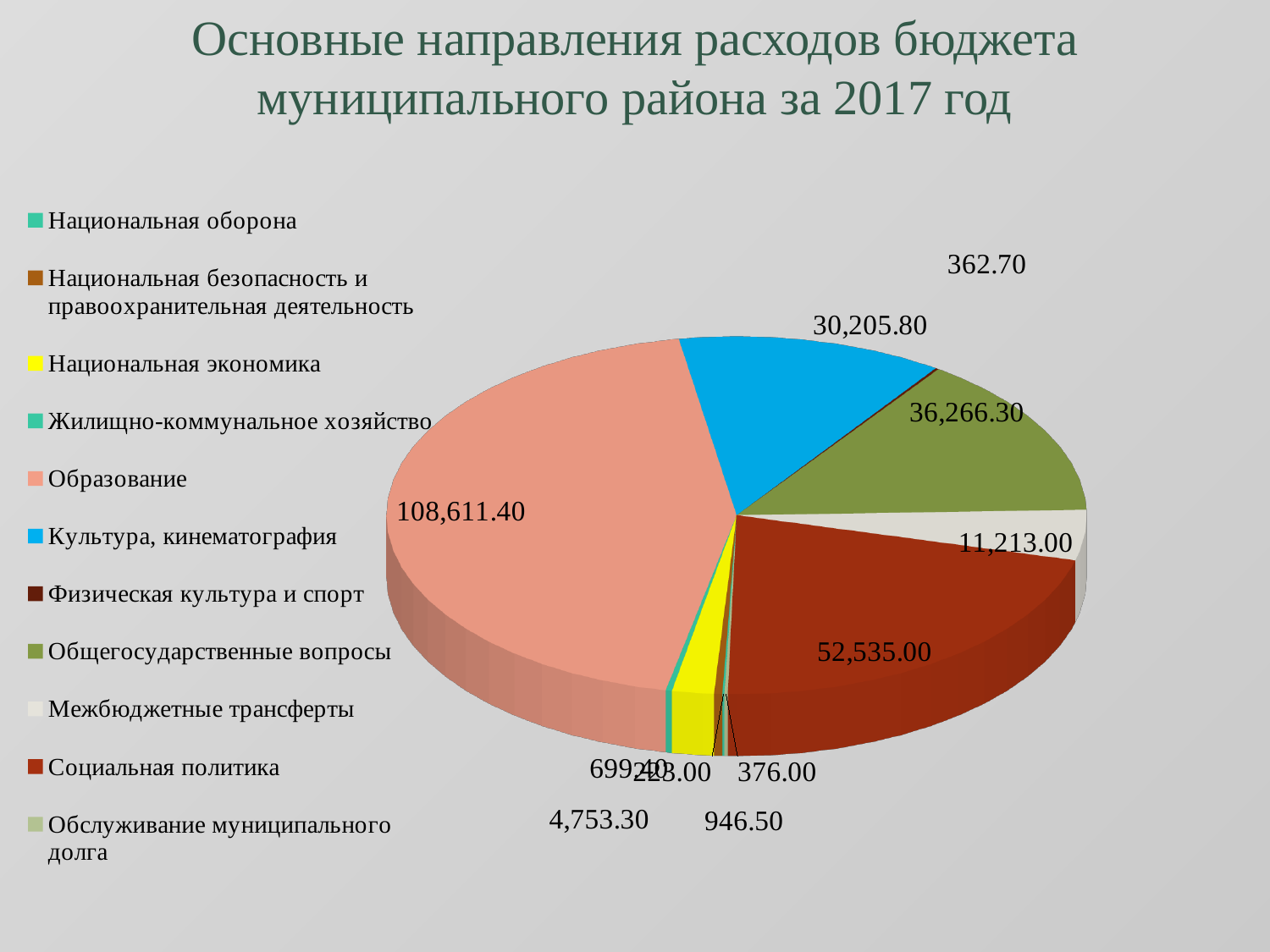
What is the value for Социальная политика? 52,535.00 What is the title of the chart? Основные направления расходов бюджета муниципального района за 2017 год What is the value for Межбюджетные трансферты? 11,213.00 Which is larger, Социальная политика or Общегосударственные вопросы? Социальная политика What kind of chart is shown on the slide? Pie chart How many categories does the legend list? 11 What is the value for Образование? 108,611.40 What is the difference between the values for Образование and Социальная политика? 56,076.40 Which category has the largest slice of the pie? Образование What is the difference between the values for Общегосударственные вопросы and Культура, кинематография? 6,060.50 What is the value for Культура, кинематография? 30,205.80 What is the value for Общегосударственные вопросы? 36,266.30